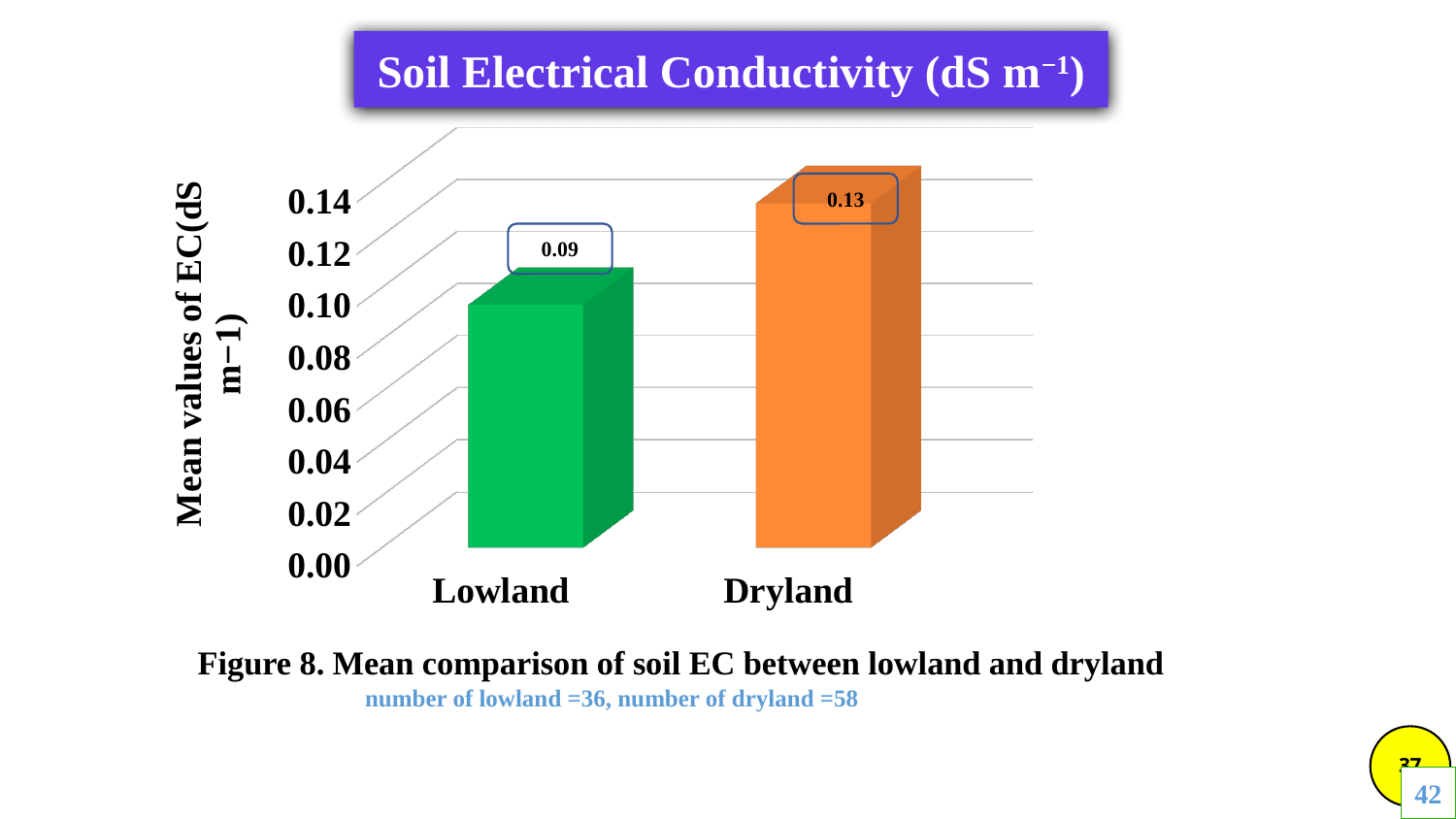
What kind of chart is shown on the slide? Bar chart What is the mean soil EC value for Dryland? 0.13 Which category has the lower mean soil EC value? Lowland Which category has the higher mean soil EC value? Dryland What is the title of the chart? Soil Electrical Conductivity (dS m⁻¹) Is the value for Lowland greater or less than 0.10? less What is the difference between the Dryland and Lowland mean soil EC values? 0.04 What is the mean soil EC value for Lowland? 0.09 Is the mean soil EC value larger for Lowland or Dryland? Dryland How many categories are shown on the x axis of the chart? 2 Is the value for Dryland greater or less than 0.12? greater What colour is the Dryland bar? Orange